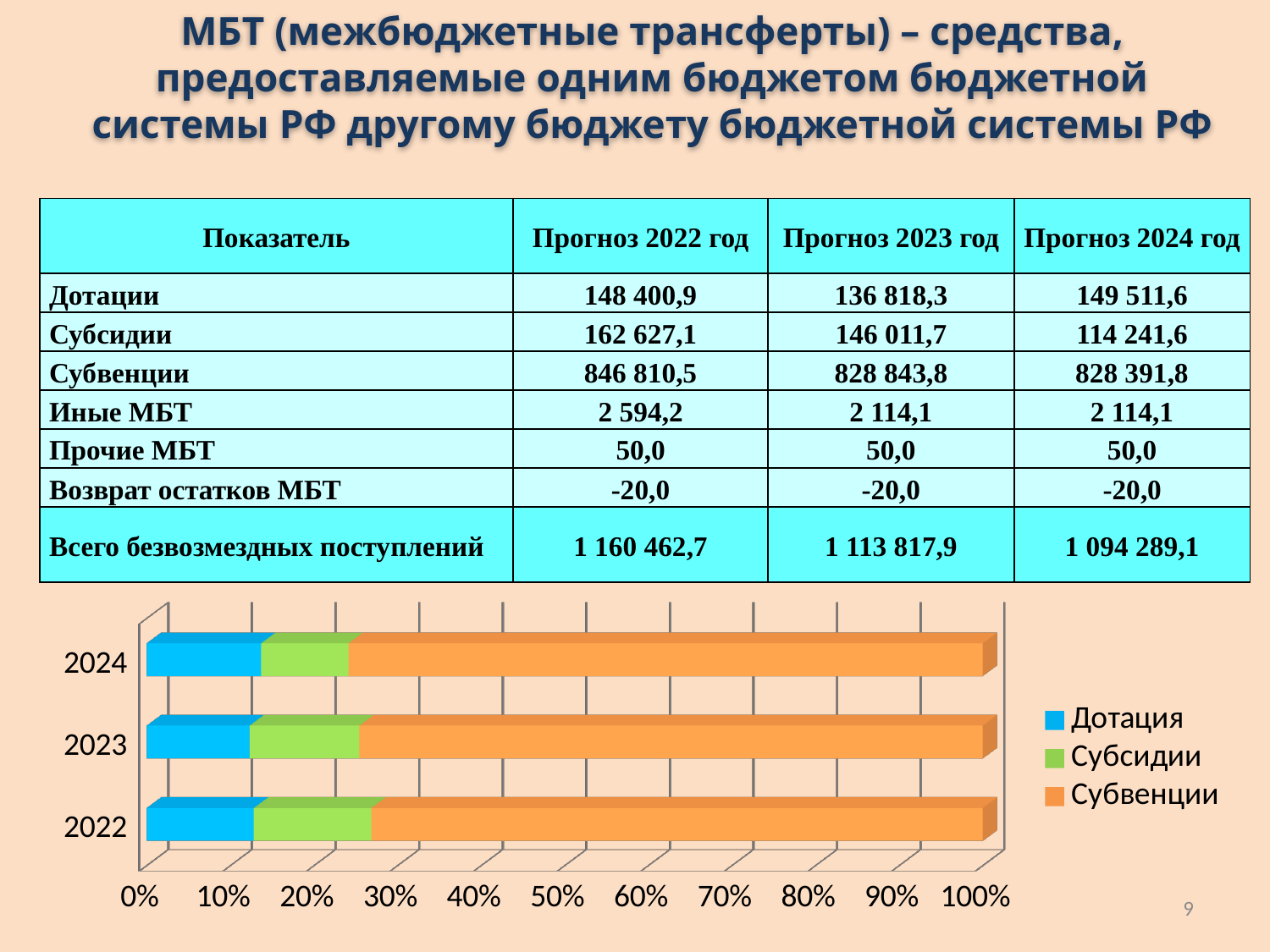
In the bar chart, is the share of Субвенции for 2022 greater or less than 60%? greater In the bar chart, which series has the smallest share in 2024? Субсидии In the bar chart, is the share of Дотация for 2022 greater or less than 20%? less How many years (categories) are plotted on the bar chart? 3 In the bar chart, is the share of Субсидии for 2024 greater or less than 20%? less Which series are listed in the legend of the bar chart? Дотация, Субсидии, Субвенции In the bar chart, which series has the largest share in 2023? Субвенции What kind of chart is shown at the bottom of the slide? bar chart What colour represents Субвенции in the bar chart? orange How many series does the legend of the bar chart list? 3 In the bar chart for 2022, which is larger: the share of Субвенции or the share of Дотация? Субвенции